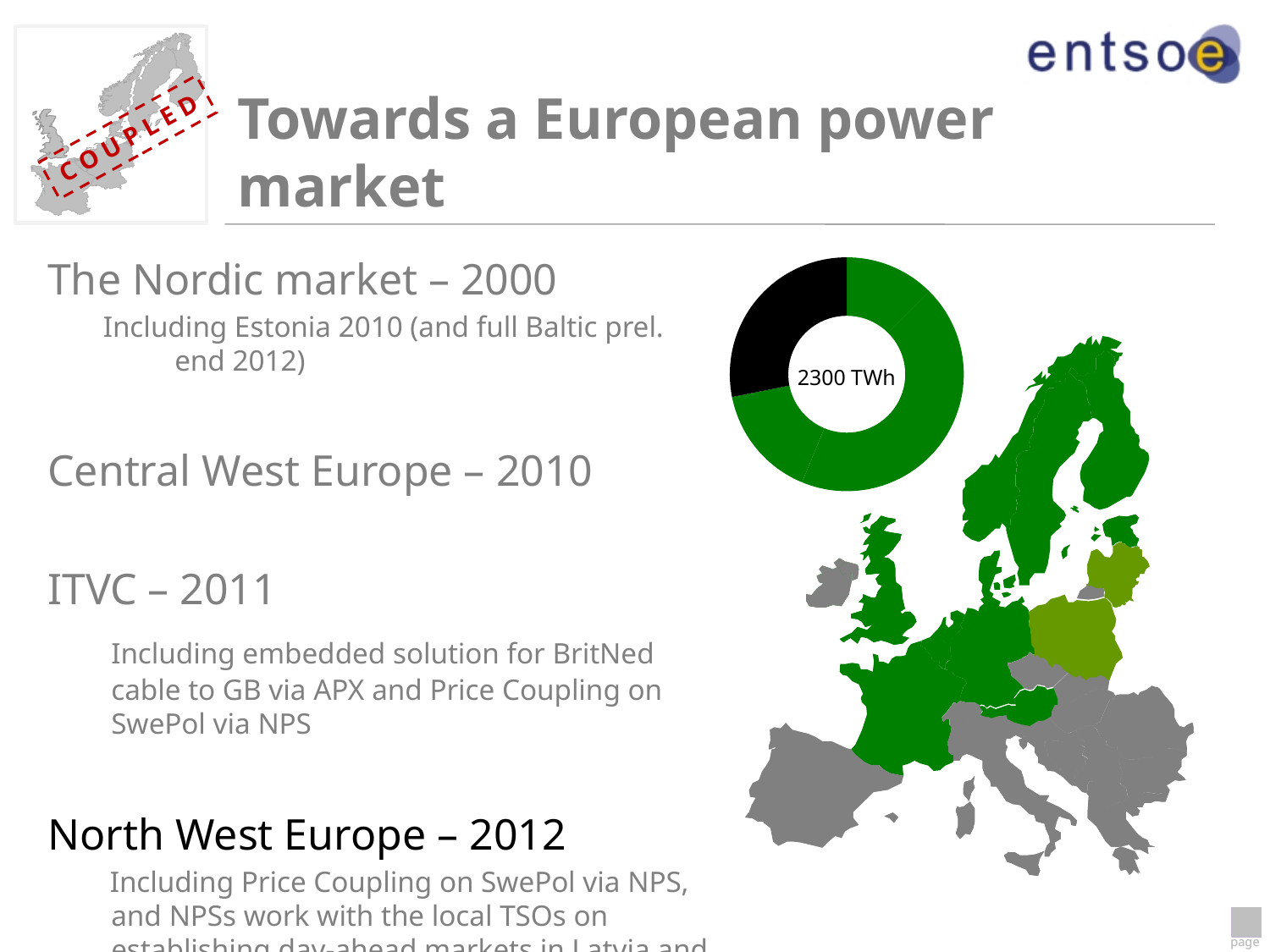
In the donut chart, which colour covers the larger share of the ring, green or black? green What two colours are used for the segments of the donut chart? green and black What value is printed in the centre of the donut chart? 2300 TWh What kind of chart is shown on the right side of the slide? pie chart (donut) Does the donut chart display a legend? No Does the black portion of the donut chart cover more or less than half of the ring? less